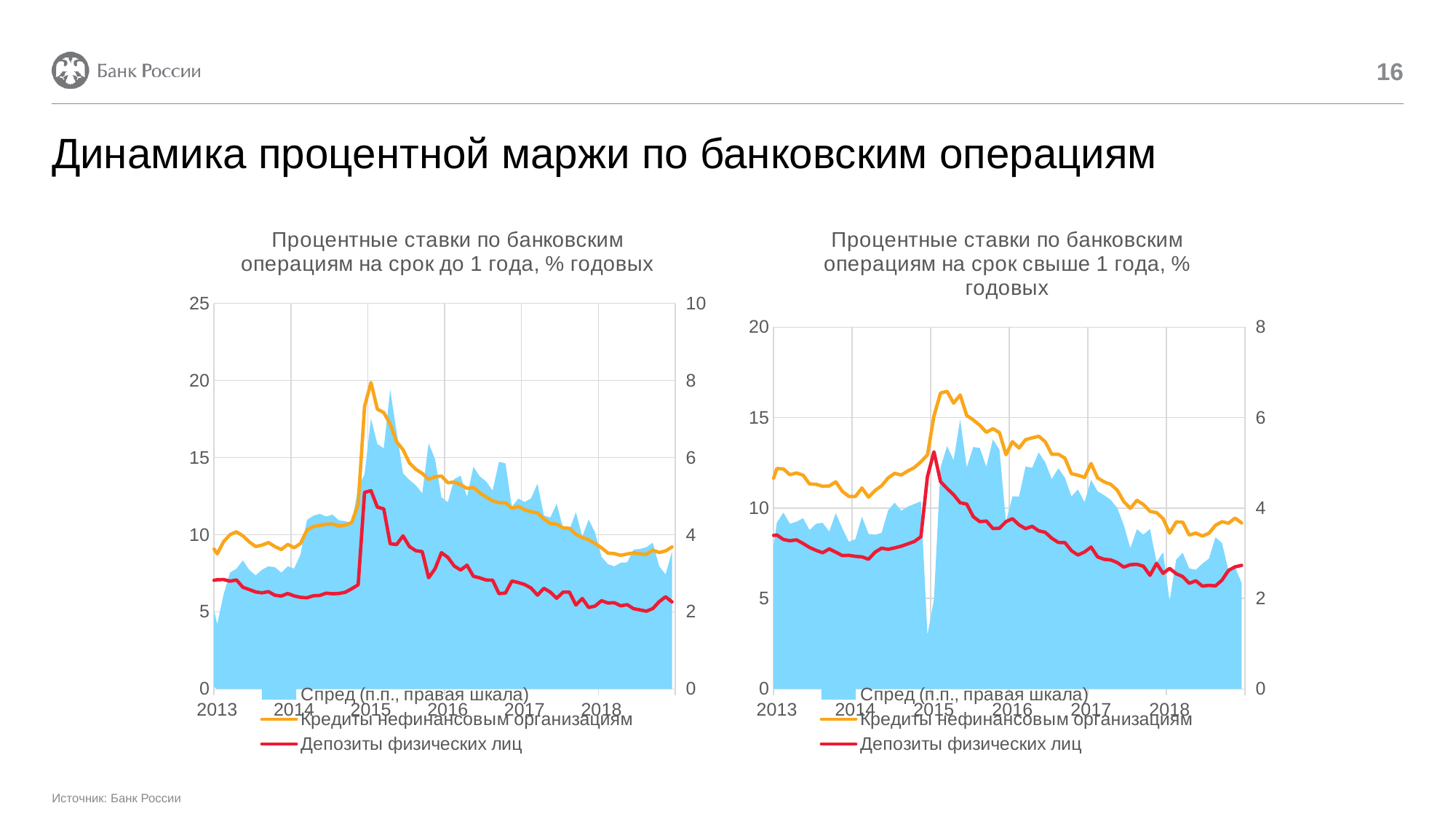
In the left chart (up to 1 year), what colour is the line for 'Кредиты нефинансовым организациям'? orange In the right chart (over 1 year), is the value of 'Кредиты нефинансовым организациям' at the start of 2013 greater or less than 10? greater In the left chart (up to 1 year), is the value of 'Депозиты физических лиц' at the start of 2013 greater or less than 10? less How many year labels are shown on the x axis of the right chart (over 1 year)? 6 In the left chart (up to 1 year), which series is higher at the start of 2013: 'Кредиты нефинансовым организациям' or 'Депозиты физических лиц'? Кредиты нефинансовым организациям In the right chart (over 1 year), is the value of 'Депозиты физических лиц' at the end of 2018 greater or less than 10? less In the left chart (up to 1 year), does the 'Кредиты нефинансовым организациям' line rise or fall from its 2015 peak to the end of 2018? fall In the right chart (over 1 year), does the 'Кредиты нефинансовым организациям' line rise or fall from 2016 to 2018? fall In the left chart (up to 1 year), which series is plotted on the right-hand scale? Спред (п.п., правая шкала) What kind of chart is the left chart, 'Процентные ставки по банковским операциям на срок до 1 года, % годовых'? line chart with a shaded area How many series does the legend of the right chart, 'Процентные ставки по банковским операциям на срок свыше 1 года, % годовых', list? 3